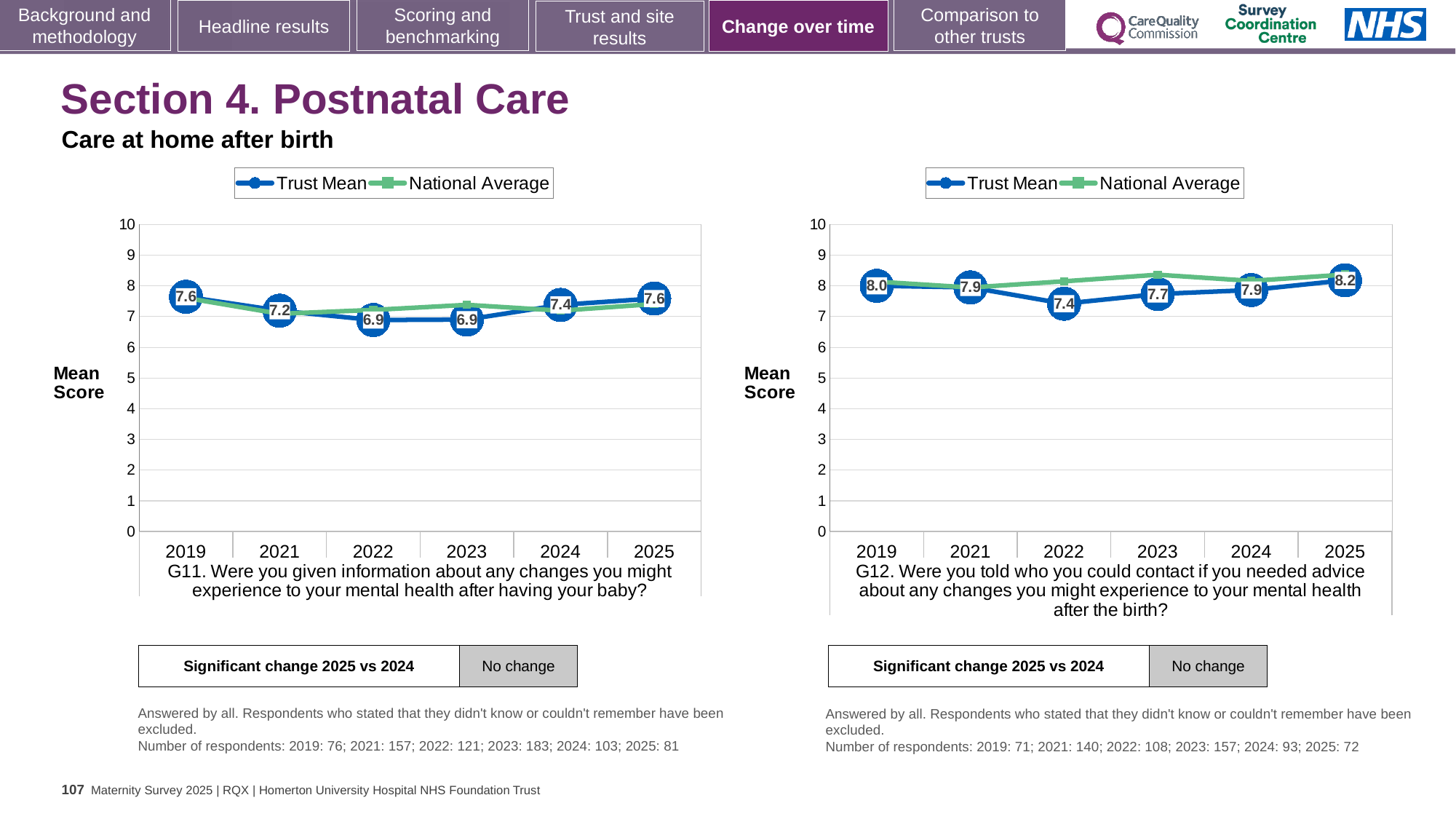
In the G12 chart, what is the difference between the Trust Mean in 2025 and in 2022? 0.8 How many years are plotted on the x axis of the G12 chart? 6 In the G11 chart, is the National Average for 2023 greater or less than 6? greater In the G12 chart, what is the Trust Mean for 2022? 7.4 In the G11 chart, is the Trust Mean higher in 2021 or in 2024? 2024 In the G11 chart, what is the Trust Mean for 2022? 6.9 In the G12 chart, what is the Trust Mean for 2025? 8.2 In the G12 chart, which year has the highest Trust Mean? 2025 In the G12 chart, which year has the lowest Trust Mean? 2022 In the G11 chart, what is the Trust Mean for 2019? 7.6 How many series does the legend of the G11 chart list? 2 In the G11 chart, what is the difference between the Trust Mean in 2025 and in 2022? 0.7